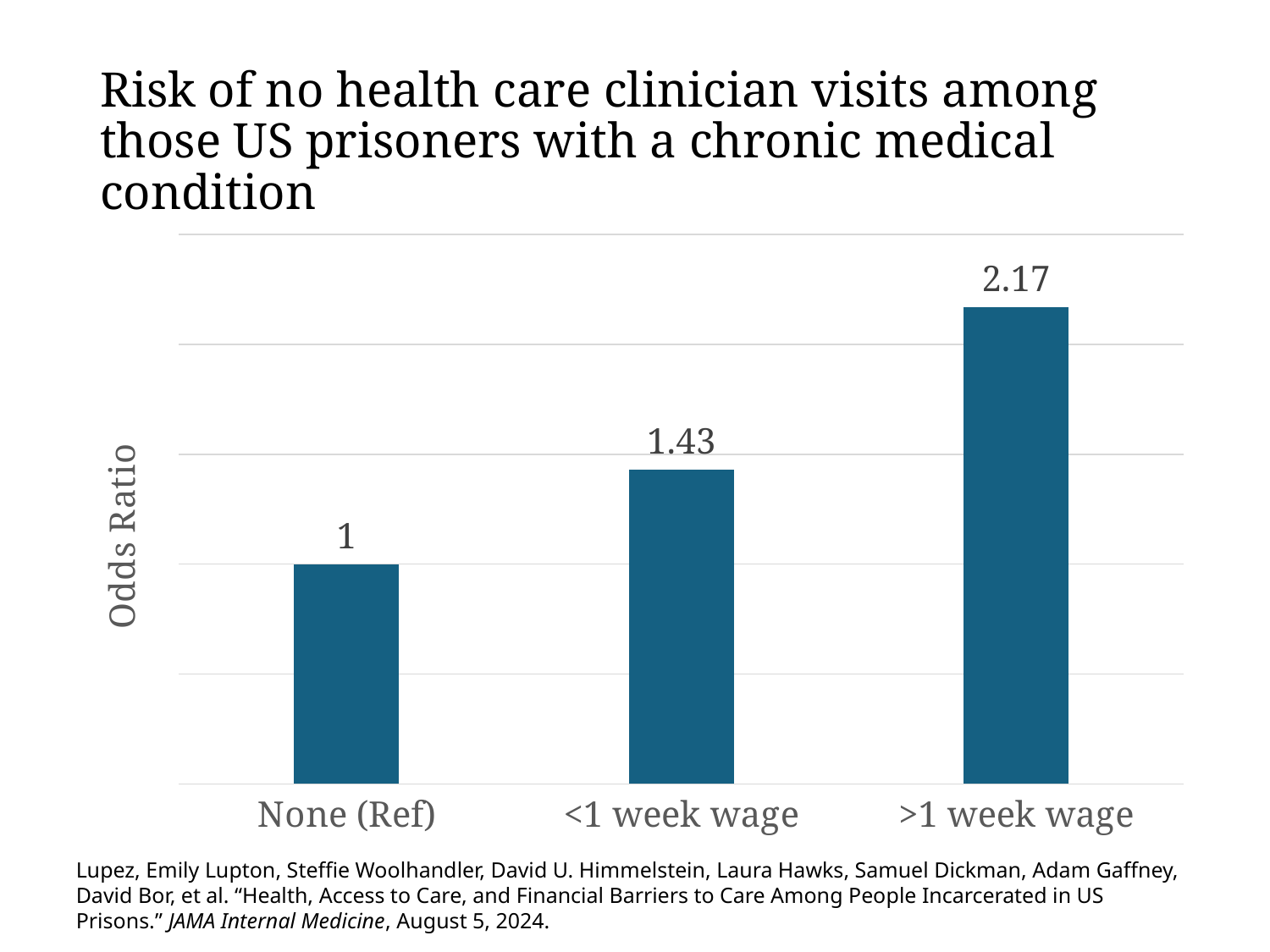
What is the odds ratio for the ">1 week wage" category? 2.17 What is the difference between the odds ratios for "<1 week wage" and "None (Ref)"? 0.43 What kind of chart is shown on the slide? Bar chart Do the odds ratios rise or fall moving from left to right across the categories? Rise What is the odds ratio for the "<1 week wage" category? 1.43 What is the label of the vertical axis? Odds Ratio Which category has the lowest odds ratio? None (Ref) How many categories are shown on the x axis? 3 Which category has the highest odds ratio? >1 week wage What is the odds ratio for the "None (Ref)" category? 1 What is the difference between the odds ratios for ">1 week wage" and "<1 week wage"? 0.74 Which has a larger odds ratio, "<1 week wage" or ">1 week wage"? >1 week wage